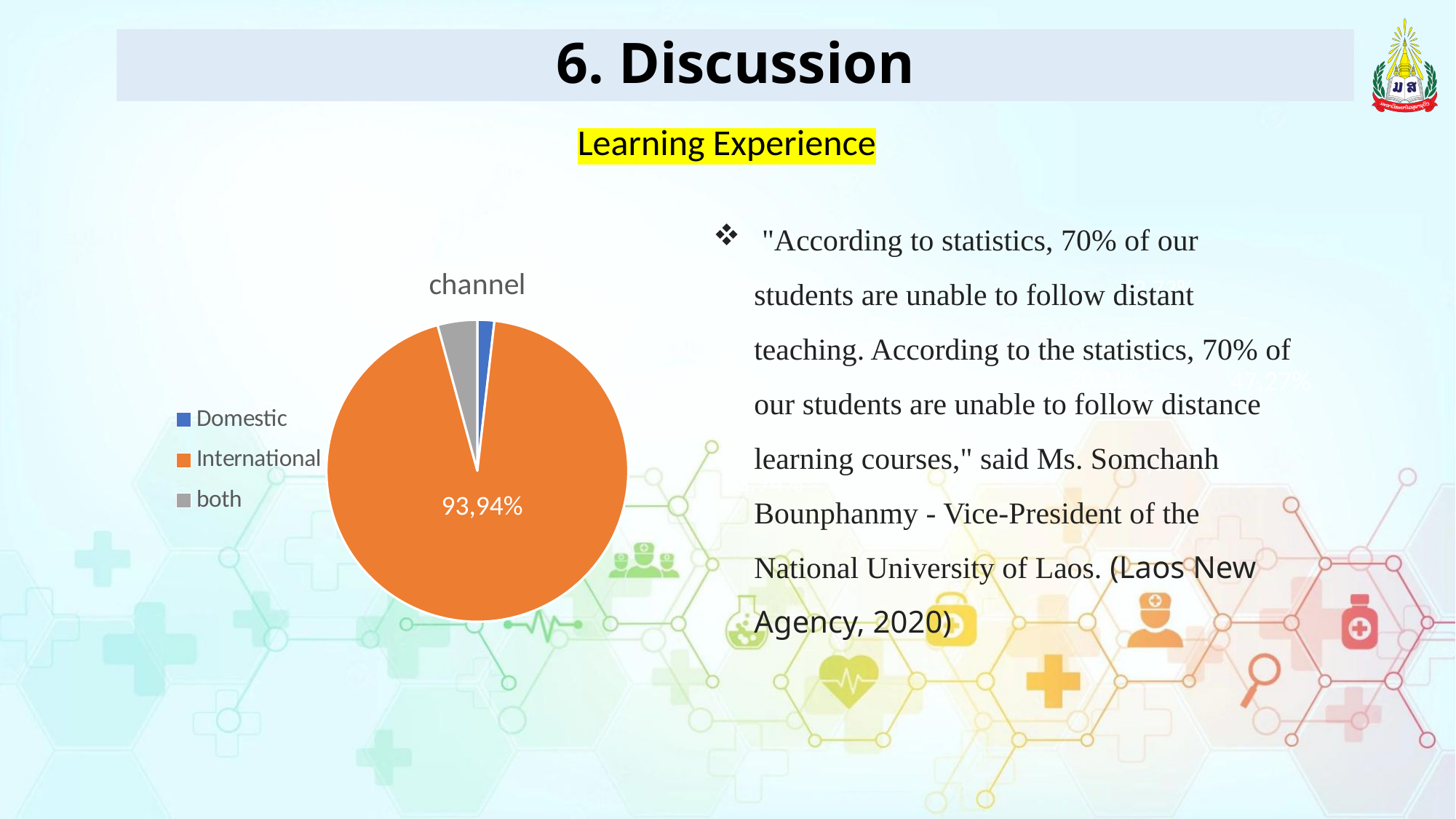
Which category has the largest slice in the pie chart? International Which slice is larger in the pie chart, International or Domestic? International What share of the pie does the International slice represent? 93,94% Is the share for International greater or less than 50%? greater What kind of chart is shown on the slide? pie chart What is the title of the pie chart? channel How many categories does the pie chart have? 3 What colour is the International slice in the pie chart? orange What percentage is shown for the International slice of the pie chart? 93,94% How many entries does the legend of the pie chart list? 3 Which category has the smallest slice in the pie chart? Domestic